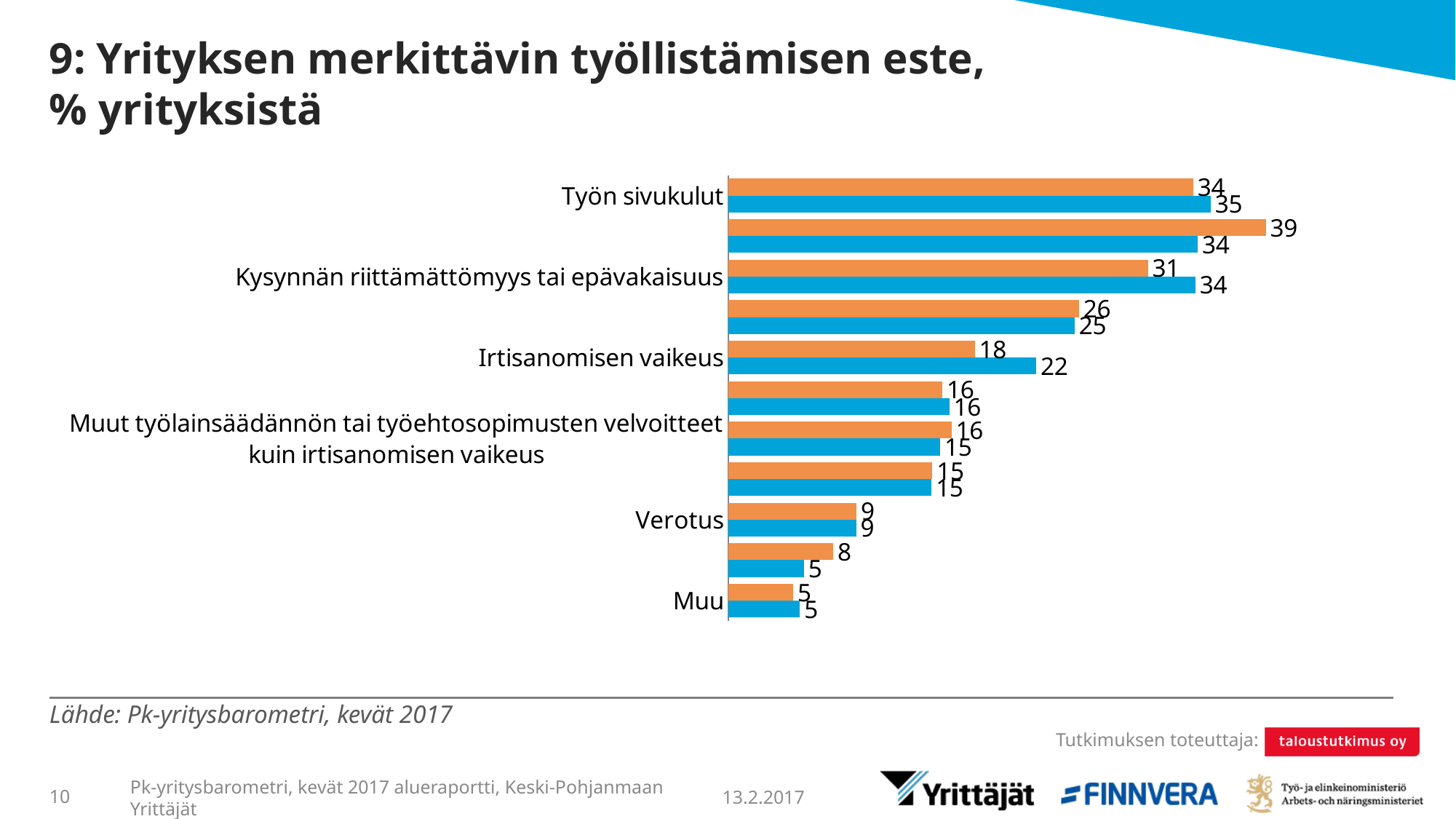
What is the title of the chart on the slide? 9: Yrityksen merkittävin työllistämisen este, % yrityksistä What value does the blue bar show for Työn sivukulut? 35 What is the difference between the blue and orange bars for Irtisanomisen vaikeus? 4 What kind of chart is shown on the slide? bar chart What value does the orange bar show for Muu? 5 What value does the blue bar show for Verotus? 9 What value does the orange bar show for Irtisanomisen vaikeus? 18 What value does the orange bar show for Työn sivukulut? 34 What is the difference between the blue and orange bars for Kysynnän riittämättömyys tai epävakaisuus? 3 Among the labelled categories, which has the lowest values? Muu What value does the blue bar show for Kysynnän riittämättömyys tai epävakaisuus? 34 Which is larger for Irtisanomisen vaikeus, the orange bar or the blue bar? the blue bar